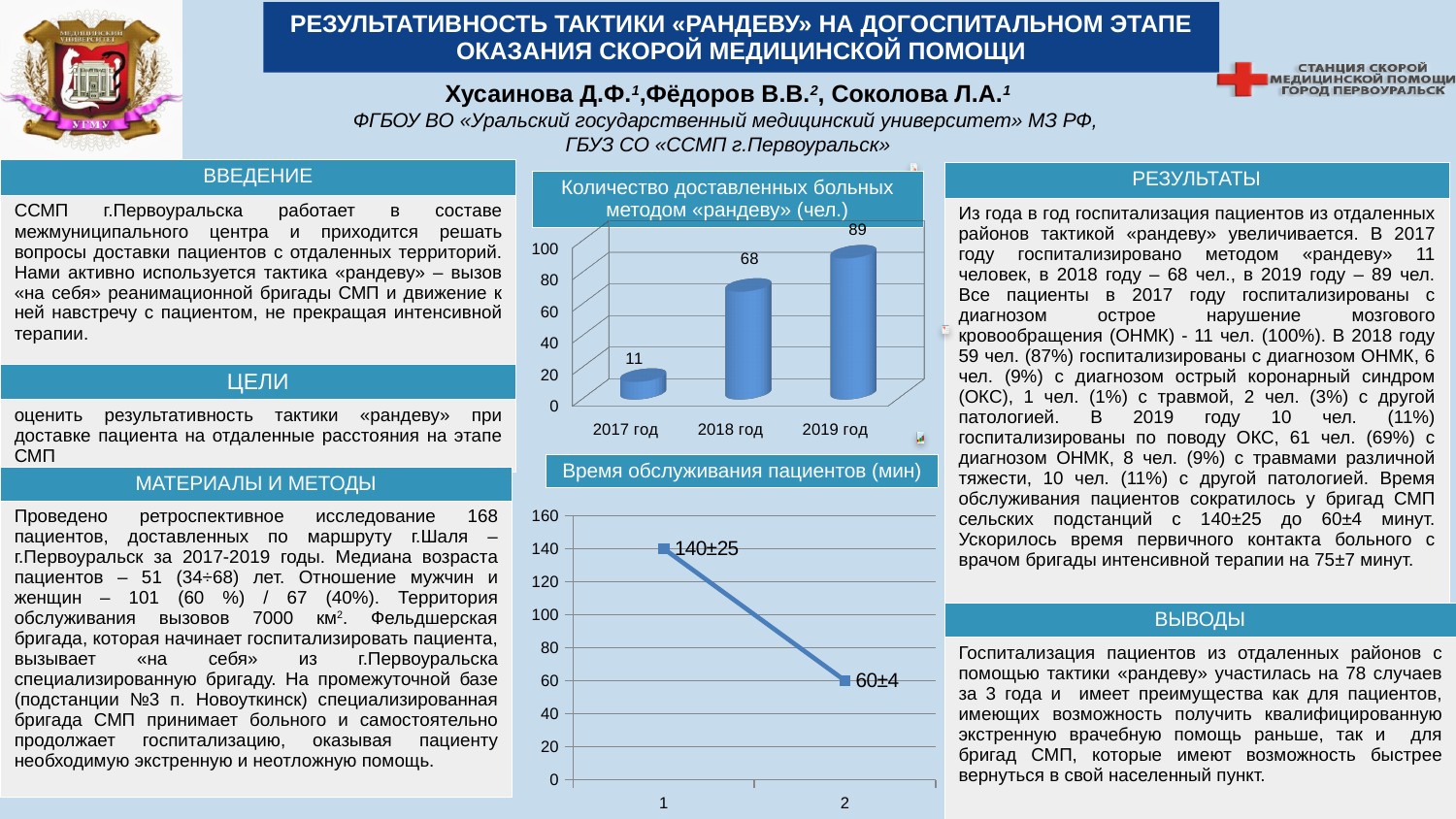
In the chart «Количество доставленных больных методом «рандеву» (чел.)», do the values rise or fall from 2017 год to 2019 год? rise In the chart «Количество доставленных больных методом «рандеву» (чел.)», what is the difference between the values for 2019 год and 2017 год? 78 In the chart «Время обслуживания пациентов (мин)», what is the data label at point 1? 140±25 In the chart «Количество доставленных больных методом «рандеву» (чел.)», is the value for 2018 год greater or less than 60? greater What kind of chart is «Время обслуживания пациентов (мин)»? line chart In the chart «Количество доставленных больных методом «рандеву» (чел.)», which year has the lowest value? 2017 год In the chart «Количество доставленных больных методом «рандеву» (чел.)», how many years are shown on the x axis? 3 What kind of chart is «Количество доставленных больных методом «рандеву» (чел.)»? bar chart In the chart «Количество доставленных больных методом «рандеву» (чел.)», what is the value for 2017 год? 11 In the chart «Количество доставленных больных методом «рандеву» (чел.)», what is the value for 2018 год? 68 In the chart «Количество доставленных больных методом «рандеву» (чел.)», which year has the highest value? 2019 год In the chart «Время обслуживания пациентов (мин)», what is the data label at point 2? 60±4